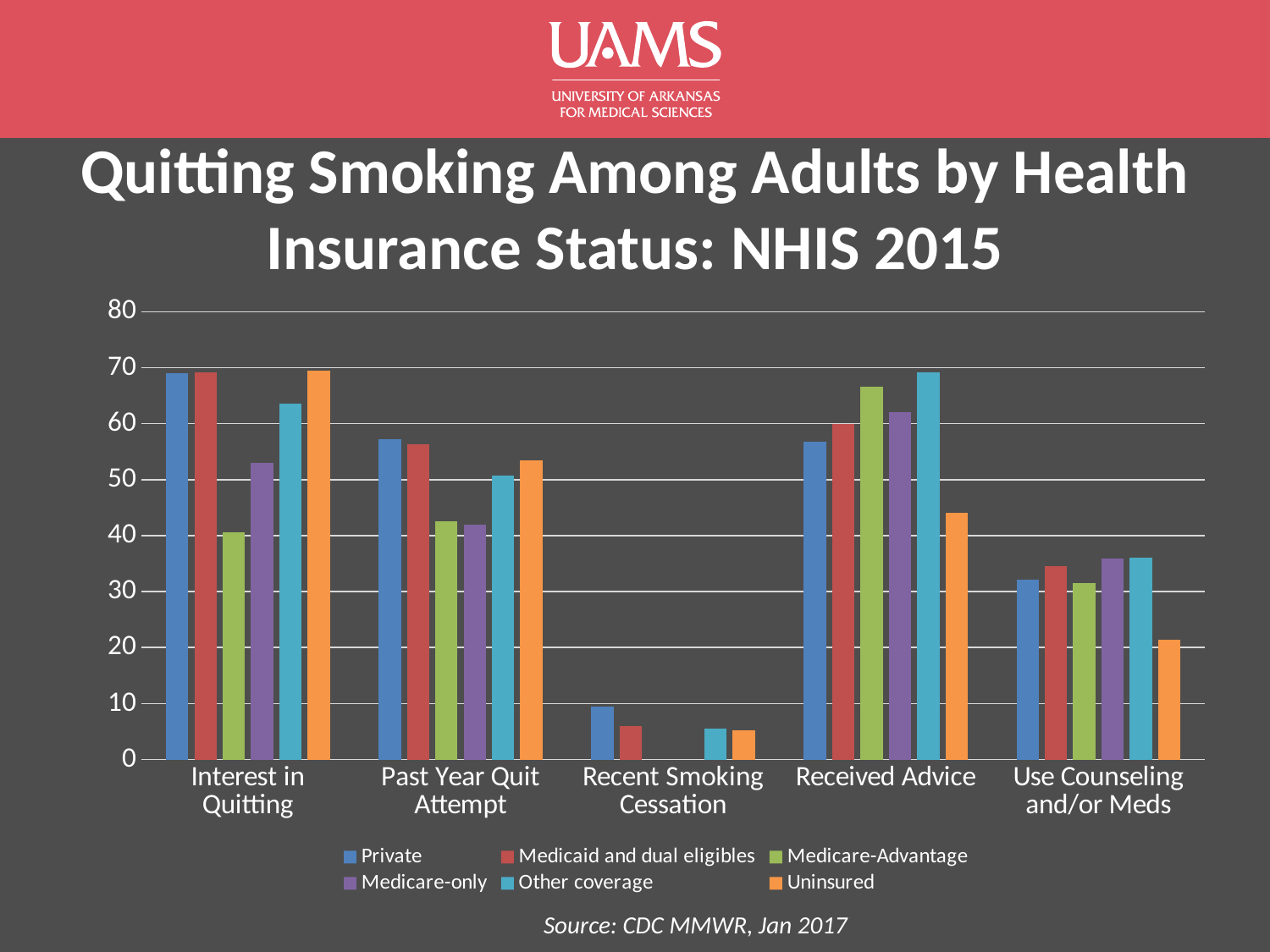
In the Interest in Quitting category, which is larger: Medicare-only or Medicare-Advantage? Medicare-only How many series does the legend list? 6 Is the value for Other coverage in the Received Advice category greater or less than 60? greater Is the value for Private in the Past Year Quit Attempt category greater or less than 50? greater How many categories are shown along the x axis? 5 In the Received Advice category, which is larger: Private or Uninsured? Private Which insurance group has the lowest value in the Received Advice category? Uninsured Is the value for Uninsured in the Use Counseling and/or Meds category greater or less than 30? less What source is cited below the chart? CDC MMWR, Jan 2017 Which insurance group has the highest value in the Received Advice category? Other coverage What kind of chart is shown on the slide? Bar chart